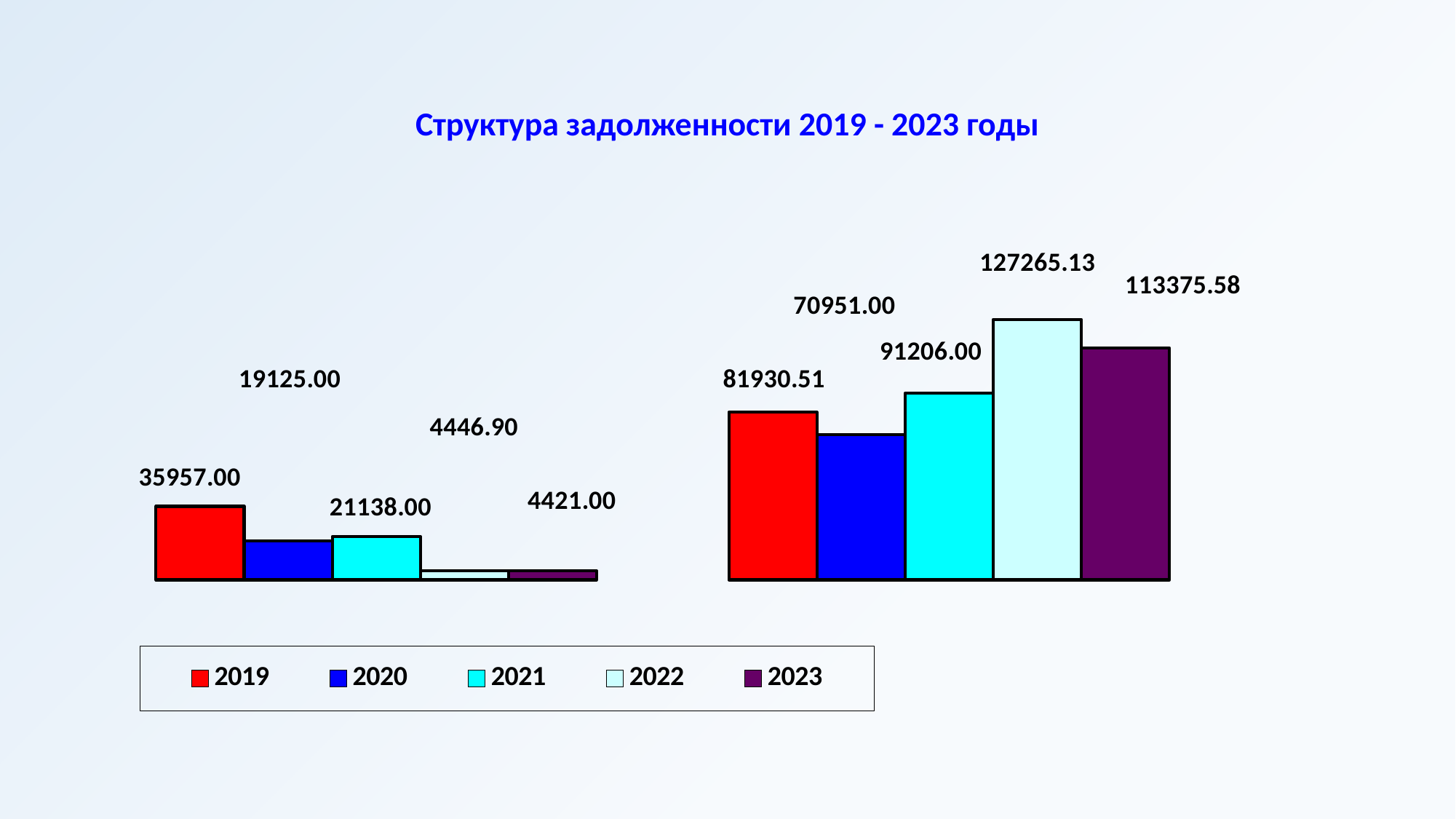
What is the title of the chart? Структура задолженности 2019 - 2023 годы In the left group of bars, which is larger: the 2020 value or the 2021 value? 2021 How many series does the legend list? 5 What is the difference between the 2022 and 2023 values in the right group of bars? 13889.55 What kind of chart is shown on the slide? bar chart What is the value for the 2022 series in the right group of bars? 127265.13 Which series has the highest value in the left group of bars? 2019 Which series has the highest value in the right group of bars? 2022 What is the value for the 2020 series in the right group of bars? 70951.00 What is the value for the 2019 series in the left group of bars? 35957.00 What is the value for the 2023 series in the left group of bars? 4421.00 Which series has the lowest value in the left group of bars? 2023